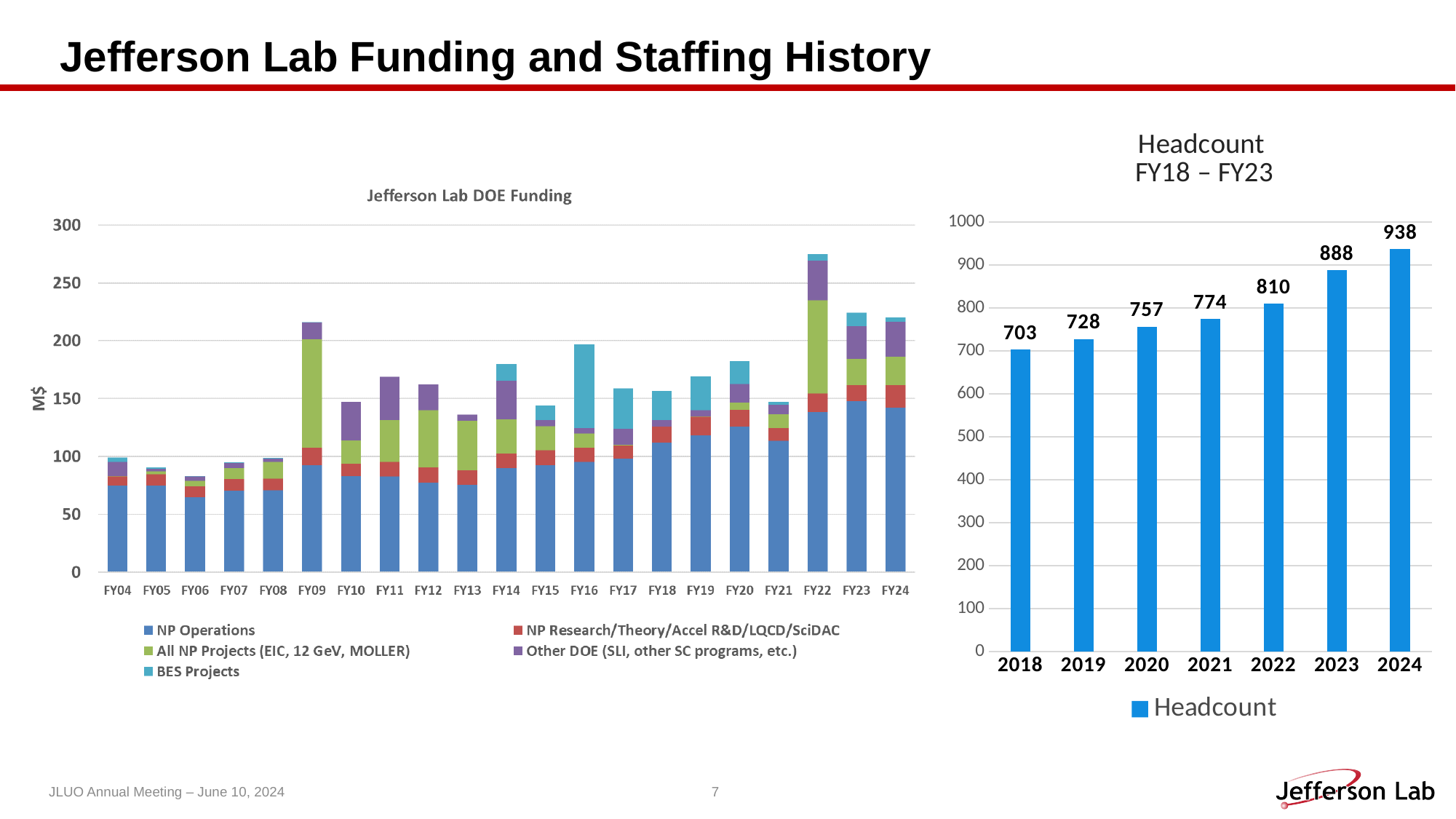
In the Headcount FY18 – FY23 chart, what is the difference between the 2024 and 2018 headcounts? 235 In the Headcount FY18 – FY23 chart, what is the headcount for 2024? 938 In the Jefferson Lab DOE Funding chart, which fiscal year has the highest total funding? FY22 What kind of chart is the Jefferson Lab DOE Funding chart? stacked bar chart In the Jefferson Lab DOE Funding chart, how many series does the legend list? 5 In the Jefferson Lab DOE Funding chart, is the total funding for FY22 greater or less than 250? greater In the Headcount FY18 – FY23 chart, how many years are plotted? 7 In the Jefferson Lab DOE Funding chart, how many fiscal years are shown on the x axis? 21 In the Headcount FY18 – FY23 chart, what is the headcount for 2021? 774 In the Headcount FY18 – FY23 chart, which year has the highest headcount? 2024 In the Headcount FY18 – FY23 chart, do the values rise or fall from 2018 to 2024? rise In the Headcount FY18 – FY23 chart, what is the headcount for 2018? 703